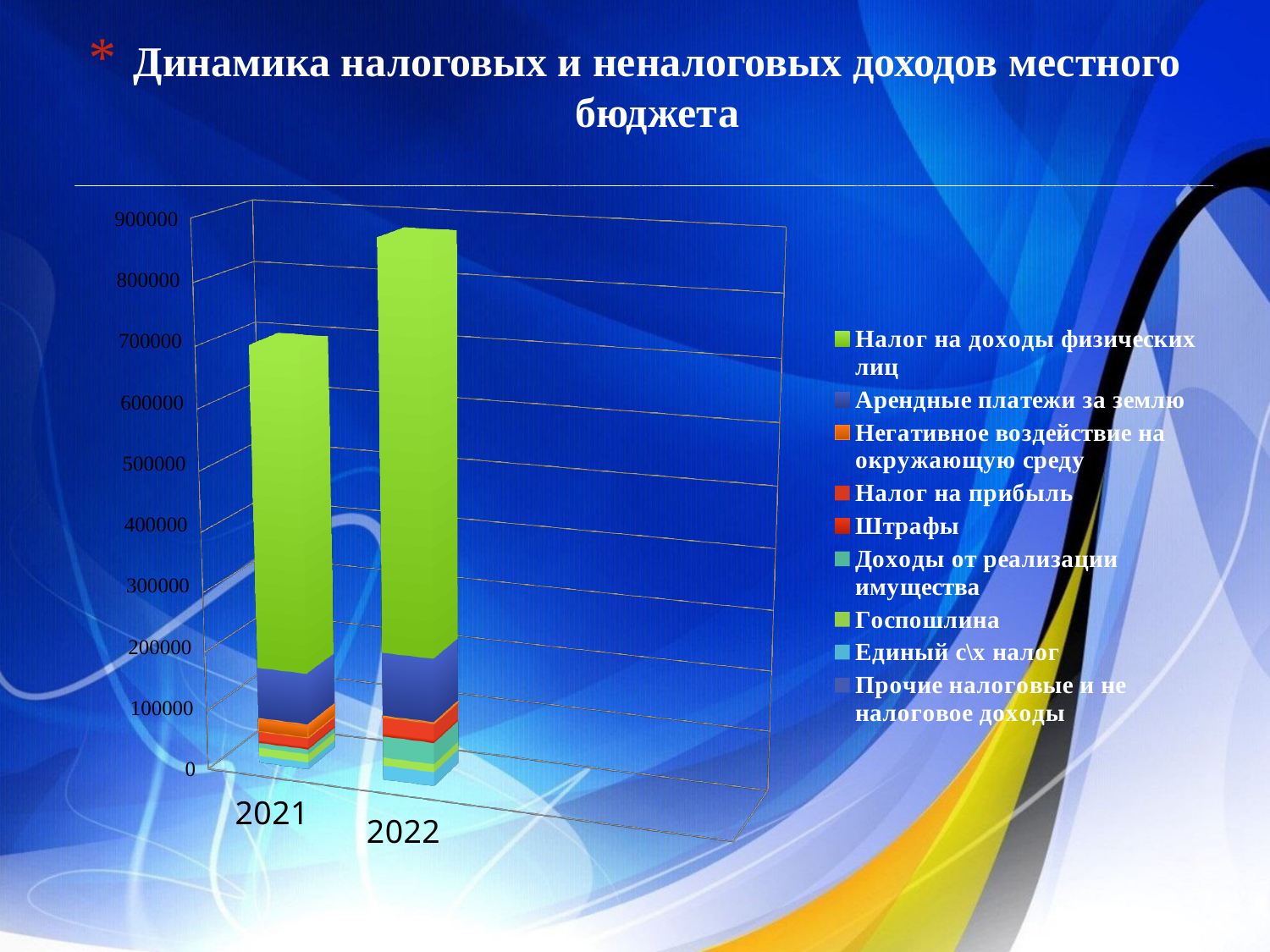
Do the total revenues rise or fall from 2021 to 2022? Rise Which series makes up the largest segment of each stacked bar? Налог на доходы физических лиц Which year has the taller stacked bar, 2021 or 2022? 2022 Is the total value of the 2022 bar greater or less than 600000? greater What is the title of the slide's chart? Динамика налоговых и неналоговых доходов местного бюджета What is the highest value shown on the vertical axis of the chart? 900000 How many series does the chart legend list? 9 Is the total value of the 2021 bar greater or less than 500000? greater How many years (categories) are shown on the x axis of the chart? 2 What kind of chart is shown on the slide? Stacked bar chart